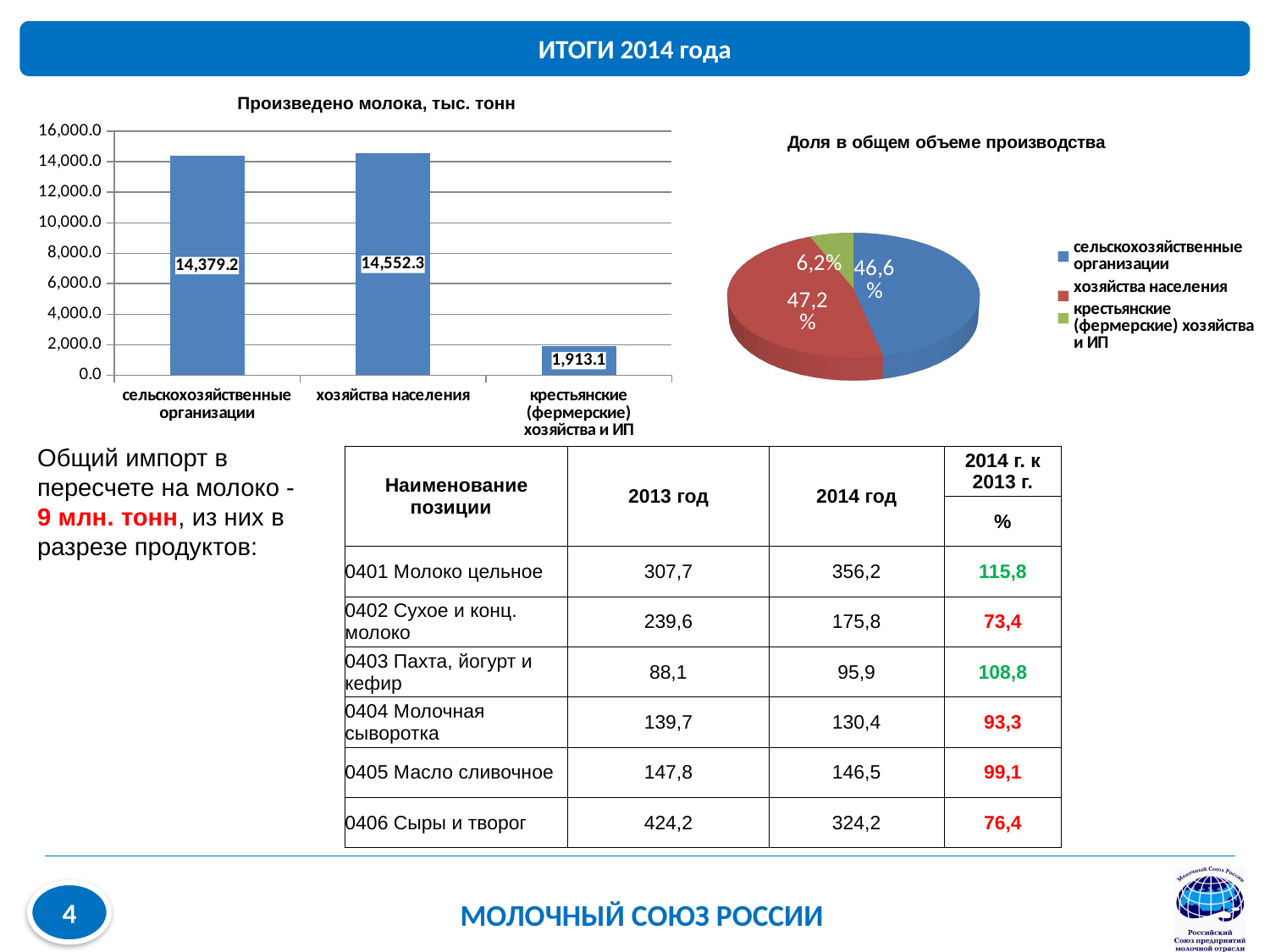
How many categories are shown in the chart 'Произведено молока, тыс. тонн'? 3 How many entries does the legend of the pie chart 'Доля в общем объеме производства' list? 3 In the chart 'Произведено молока, тыс. тонн', what is the value for крестьянские (фермерские) хозяйства и ИП? 1,913.1 In the chart 'Произведено молока, тыс. тонн', what is the value for сельскохозяйственные организации? 14,379.2 In the chart 'Произведено молока, тыс. тонн', what is the value for хозяйства населения? 14,552.3 In the chart 'Произведено молока, тыс. тонн', is the value for крестьянские (фермерские) хозяйства и ИП greater or less than 2,000.0? less In the chart 'Произведено молока, тыс. тонн', which category has the highest value? хозяйства населения In the pie chart 'Доля в общем объеме производства', what share is shown for крестьянские (фермерские) хозяйства и ИП? 6,2% In the pie chart 'Доля в общем объеме производства', what share is shown for хозяйства населения? 47,2% In the chart 'Произведено молока, тыс. тонн', which category has the lowest value? крестьянские (фермерские) хозяйства и ИП What kind of chart is 'Произведено молока, тыс. тонн'? bar chart In the chart 'Произведено молока, тыс. тонн', what is the difference between хозяйства населения and сельскохозяйственные организации? 173.1